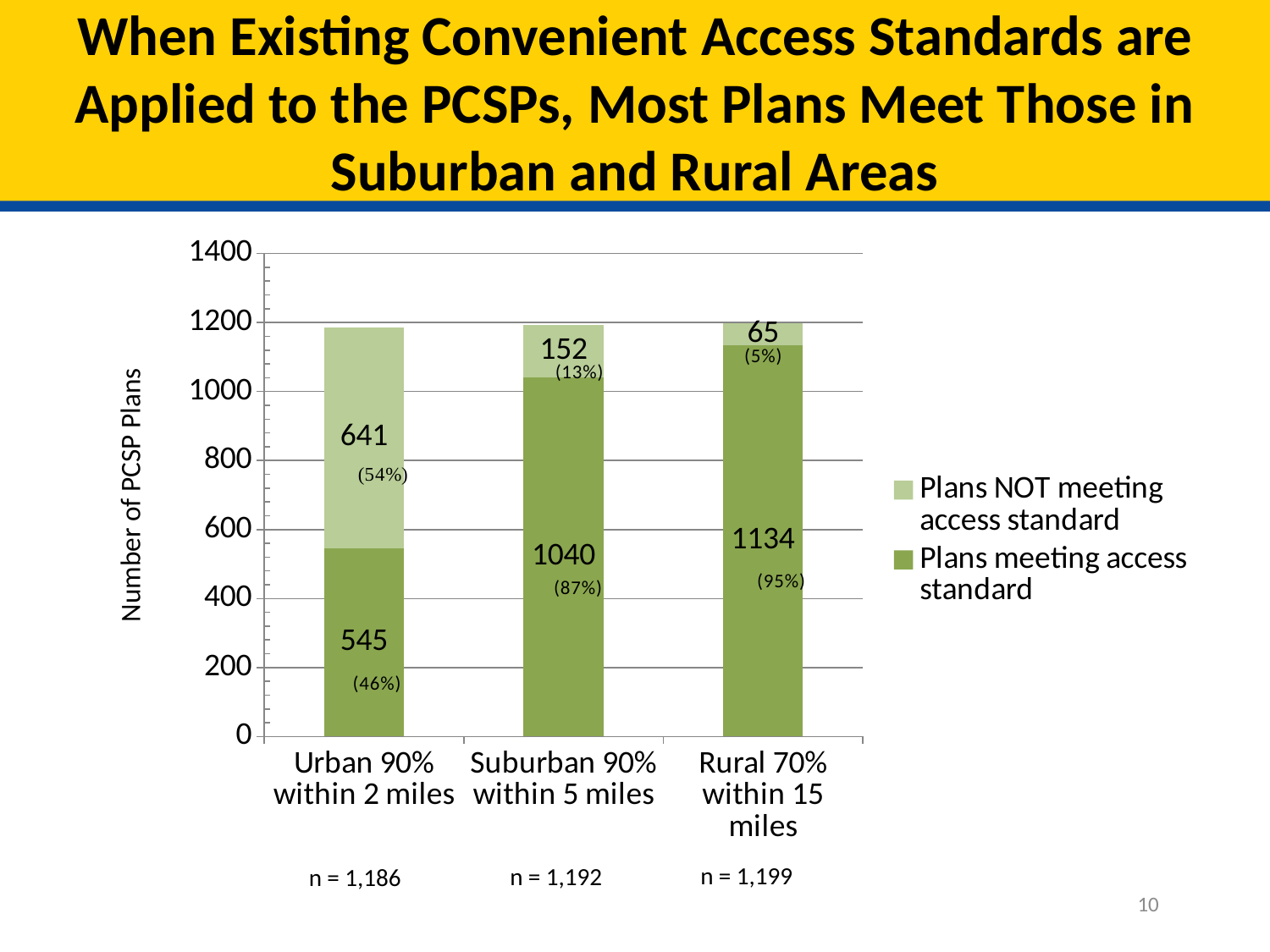
What percentage of Urban plans do NOT meet the access standard? 54% How many PCSP plans meet the access standard in the Urban 90% within 2 miles category? 545 Which category has the lowest number of plans NOT meeting the access standard? Rural 70% within 15 miles Which is larger: the number of Urban plans meeting the access standard or the number of Urban plans NOT meeting it? Plans NOT meeting access standard How many plans do NOT meet the access standard in the Suburban 90% within 5 miles category? 152 How many categories are shown on the x axis? 3 How many series does the legend list? 2 What is the total number of plans in the Suburban 90% within 5 miles bar? 1,192 What kind of chart is shown on the slide? Stacked bar chart What is the difference between the number of plans meeting the access standard in Suburban and Urban areas? 495 How many plans meet the access standard in the Rural 70% within 15 miles category? 1134 Which category has the highest number of plans meeting the access standard? Rural 70% within 15 miles